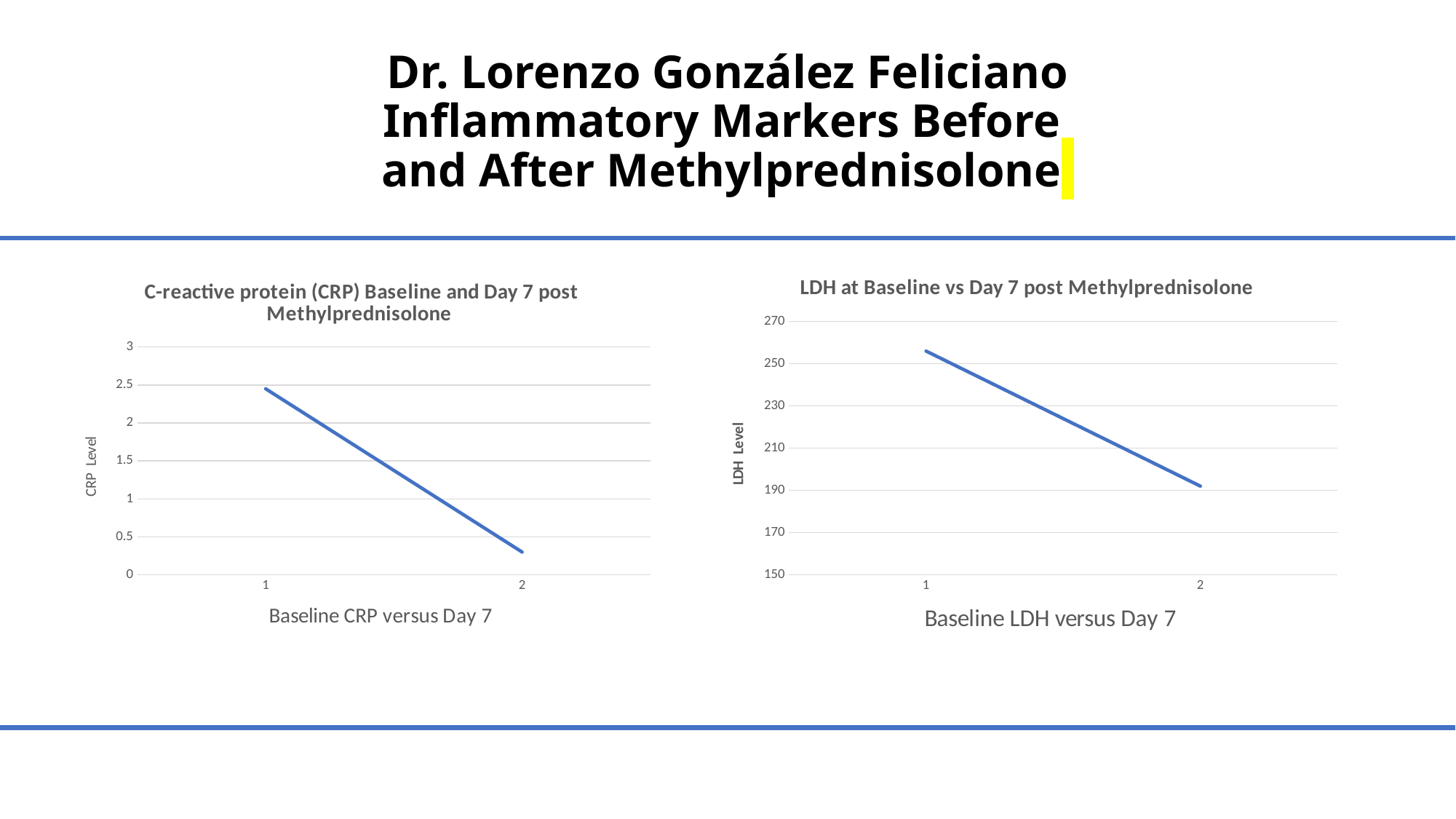
In the LDH chart on the right, do the values rise or fall from point 1 to point 2? fall In the LDH chart on the right, is the value at point 2 greater or less than 210? less How many points are plotted on the LDH chart on the right? 2 In the CRP chart on the left, is the value at point 2 greater or less than 0.5? less What kind of chart is the LDH chart on the right? line chart In the LDH chart on the right, which point has the higher value, 1 or 2? 1 What is the x-axis label of the LDH chart on the right? Baseline LDH versus Day 7 What kind of chart is the C-reactive protein (CRP) chart on the left? line chart In the CRP chart on the left, is the value at point 1 greater or less than 2? greater In the CRP chart on the left, do the values rise or fall from point 1 to point 2? fall How many points are plotted on the CRP chart on the left? 2